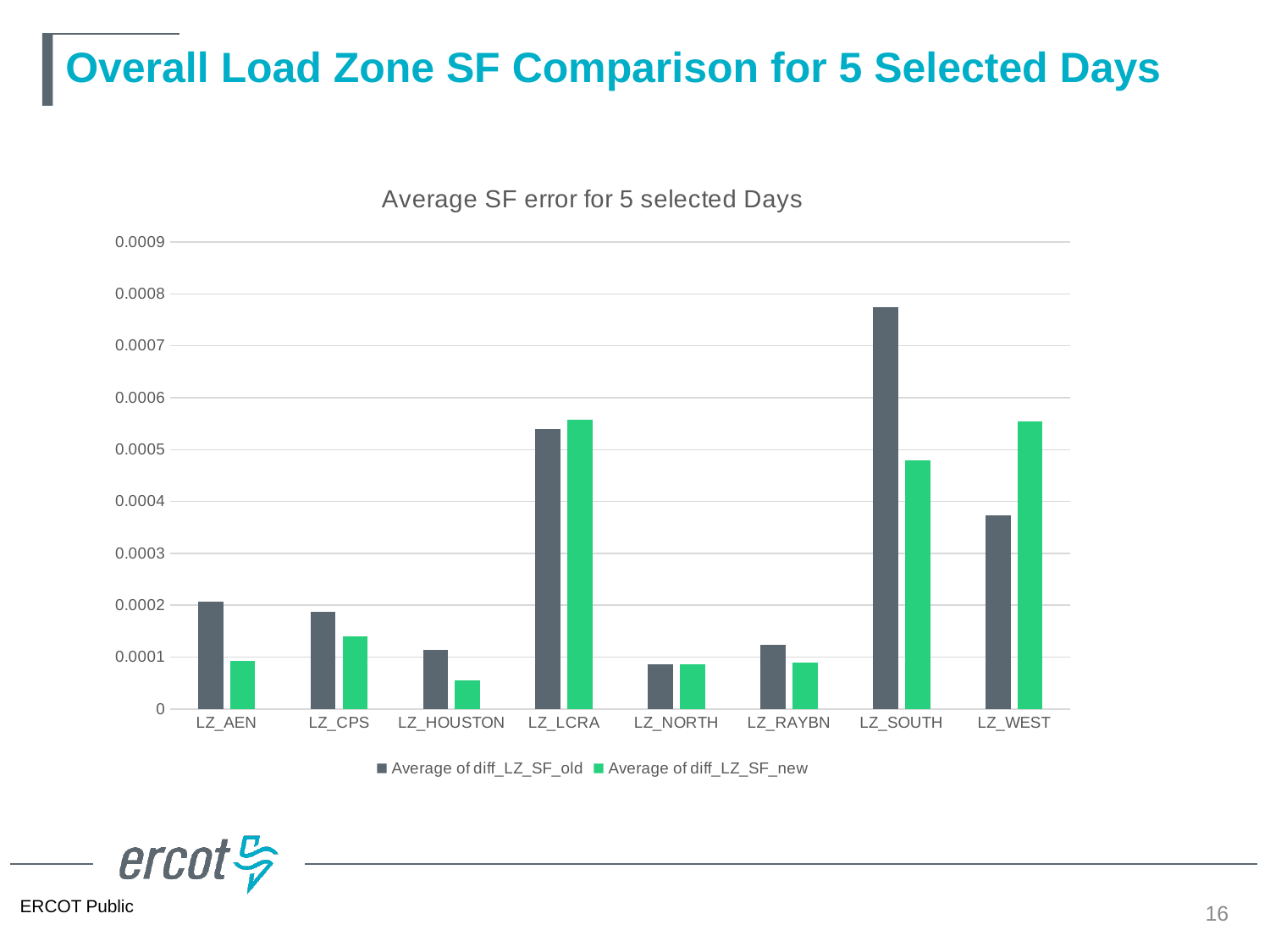
Which colour represents the Average of diff_LZ_SF_new series? green Is the value for Average of diff_LZ_SF_new at LZ_HOUSTON greater or less than 0.0001? less For LZ_WEST, which is larger: Average of diff_LZ_SF_old or Average of diff_LZ_SF_new? Average of diff_LZ_SF_new How many load zone categories are shown on the x axis? 8 Is the value for Average of diff_LZ_SF_old at LZ_SOUTH greater or less than 0.0007? greater Which load zone has the lowest value for Average of diff_LZ_SF_new? LZ_HOUSTON Which load zone has the highest value for Average of diff_LZ_SF_old? LZ_SOUTH What kind of chart is shown on the slide? bar chart What is the title of the chart? Average SF error for 5 selected Days Is the value for Average of diff_LZ_SF_old at LZ_LCRA greater or less than 0.0005? greater For LZ_SOUTH, which is larger: Average of diff_LZ_SF_old or Average of diff_LZ_SF_new? Average of diff_LZ_SF_old How many series does the legend list? 2